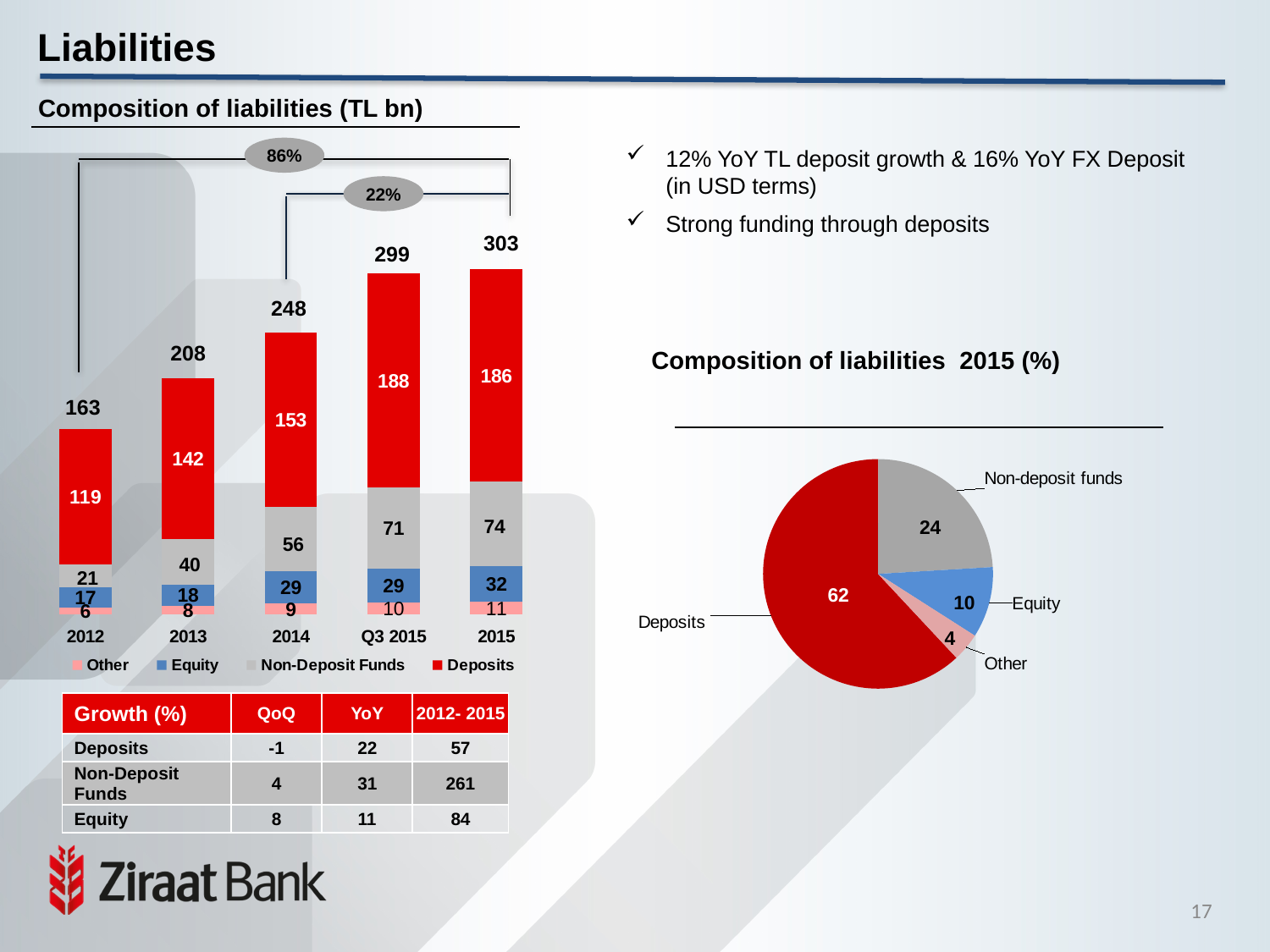
In the 'Composition of liabilities (TL bn)' bar chart, how many series does the legend list? 4 In the 'Composition of liabilities (TL bn)' bar chart, what is the total of the stacked bar for 2015? 303 In the 'Composition of liabilities (TL bn)' bar chart, which year has the lowest total liabilities? 2012 In the 'Composition of liabilities 2015 (%)' pie chart, which category has the smallest slice? Other In the 'Composition of liabilities (TL bn)' bar chart, is the Equity value larger in 2015 or in Q3 2015? 2015 In the 'Composition of liabilities (TL bn)' bar chart, what is the Non-Deposit Funds value for Q3 2015? 71 In the 'Composition of liabilities (TL bn)' bar chart, how many periods are shown on the x axis? 5 In the 'Composition of liabilities (TL bn)' bar chart, what is the difference between the Deposits values for 2013 and 2012? 23 What kind of chart is 'Composition of liabilities 2015 (%)'? pie chart In the 'Composition of liabilities (TL bn)' bar chart, do the total liabilities rise or fall from 2012 to 2015? rise In the 'Composition of liabilities 2015 (%)' pie chart, what share do Deposits have? 62 In the 'Composition of liabilities (TL bn)' bar chart, what is the Deposits value for 2014? 153